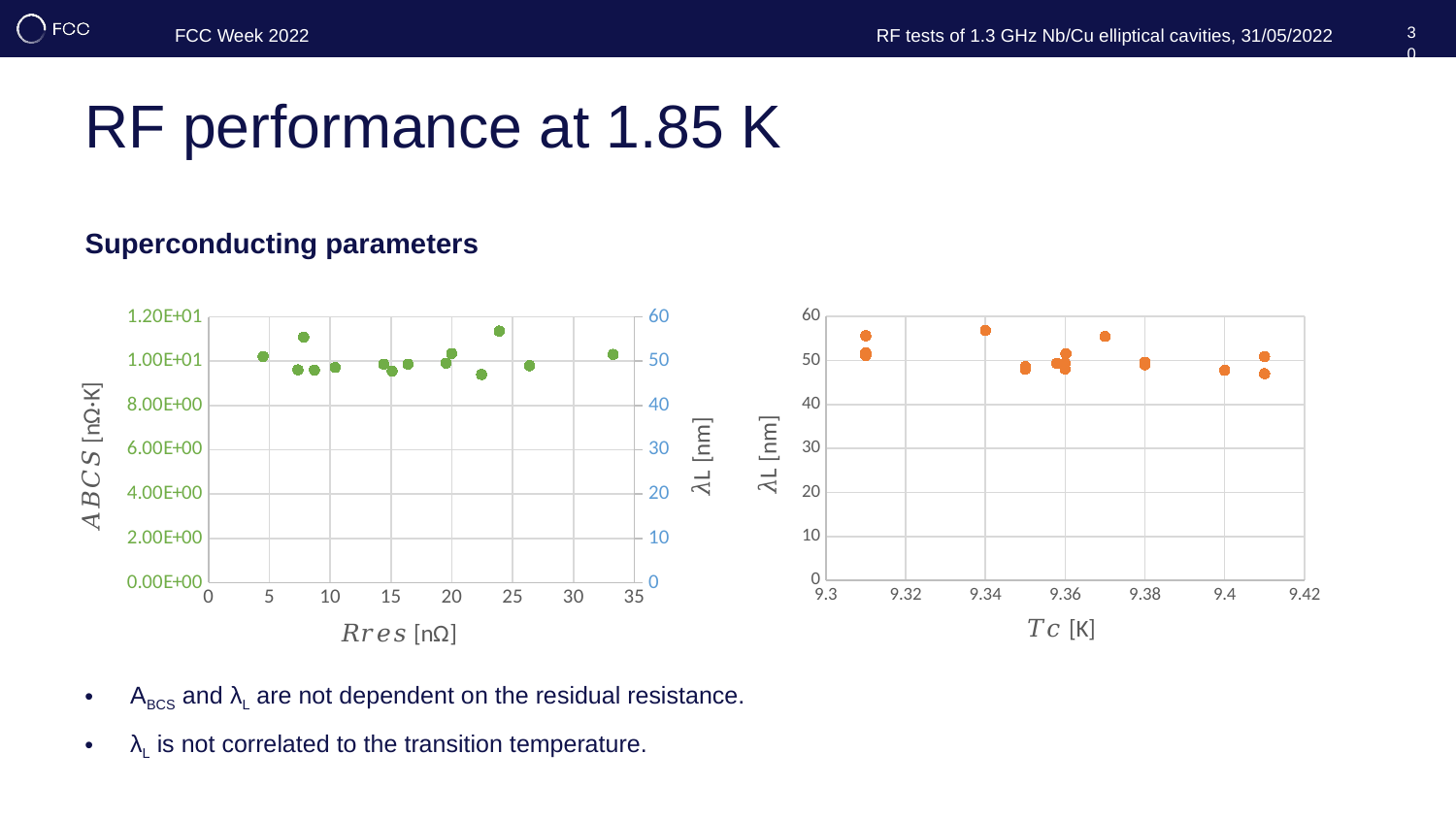
On the right chart, are all plotted λL values greater or less than 40? greater On the right chart, is the λL value of the point at Tc ≈ 9.40 K greater or less than 50? less On the left chart, what is the label of the x axis? Rres [nΩ] On the left chart, is the ABCS value of the point at Rres ≈ 24 nΩ greater or less than 1.00E+01? greater On the right chart, do the λL values show a clear rising or falling trend as Tc increases? no clear trend On the right chart, what is the label of the x axis? Tc [K] On the right chart, which point has the highest λL value: the one at Tc ≈ 9.34 K or the one at Tc ≈ 9.41 K? Tc ≈ 9.34 K What is the maximum value shown on the y axis of the right chart? 60 What kind of chart is the left chart plotting ABCS against Rres? scatter chart What kind of chart is the right chart plotting λL against Tc? scatter chart